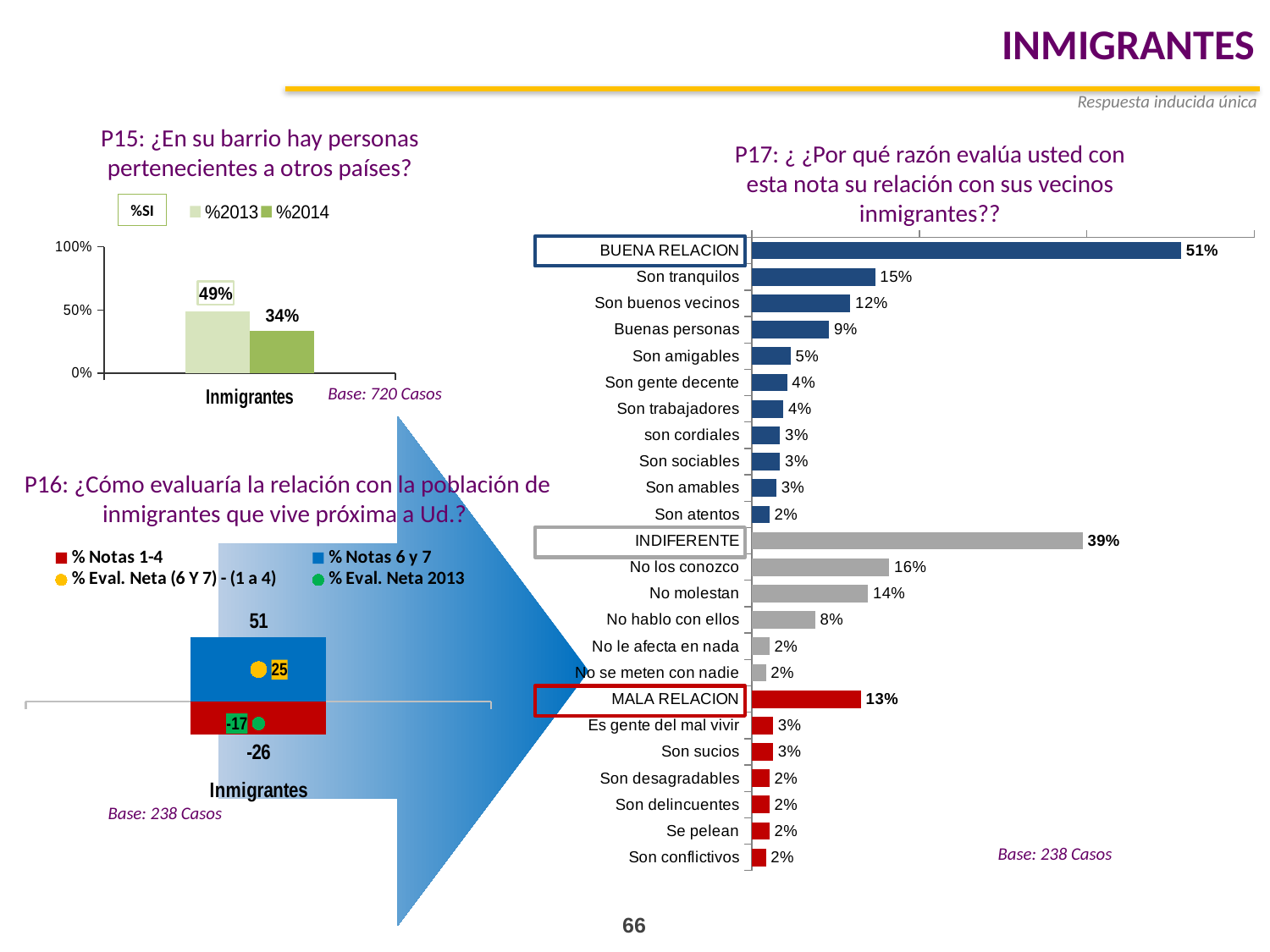
In the P17 chart, which is larger, INDIFERENTE or MALA RELACION? INDIFERENTE In the P17 chart, what is the difference between Son tranquilos and Son buenos vecinos? 3% In the P15 chart, how many series does the legend list? 2 In the P16 chart, what is the % Eval. Neta (6 Y 7) - (1 a 4) value? 25 In the P16 chart, what is the value for % Notas 1-4 for Inmigrantes? -26 In the P15 chart, what is the difference between the %2013 and %2014 values for Inmigrantes? 15% In the P15 chart, what is the %2014 value for Inmigrantes? 34% What kind of chart is the P17 chart? Bar chart In the P17 chart, what is the value for No los conozco? 16% In the P17 chart, what is the value for BUENA RELACION? 51% In the P15 chart, what is the %2013 value for Inmigrantes? 49% In the P16 chart, what is the value for % Notas 6 y 7 for Inmigrantes? 51